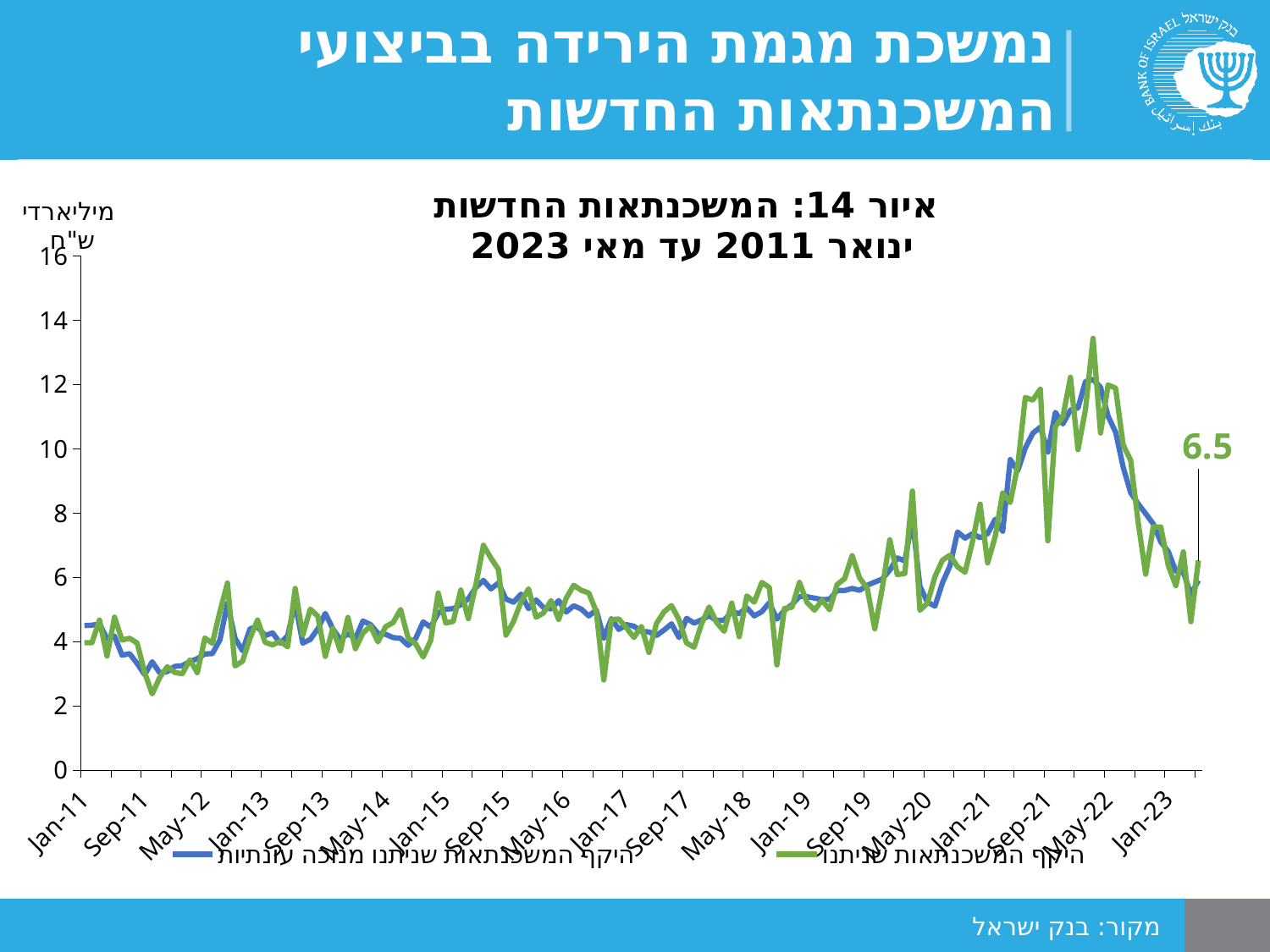
How many series does the legend list? 2 Is the peak value of the green series (around May-22) greater or less than 12? greater Do the values rise or fall between May-22 and Jan-23? fall What value is printed as the data label at the end of the series (May 2023)? 6.5 Is the value of the blue series at Jan-23 greater or less than 10? less Is the value of the green series at Jan-11 greater or less than 6? less Do the values generally rise or fall between Jan-19 and May-22? rise What unit is shown on the y axis of the chart? מיליארדי ש"ח What kind of chart is shown on the slide? line chart What is the title of the chart? איור 14: המשכנתאות החדשות ינואר 2011 עד מאי 2023